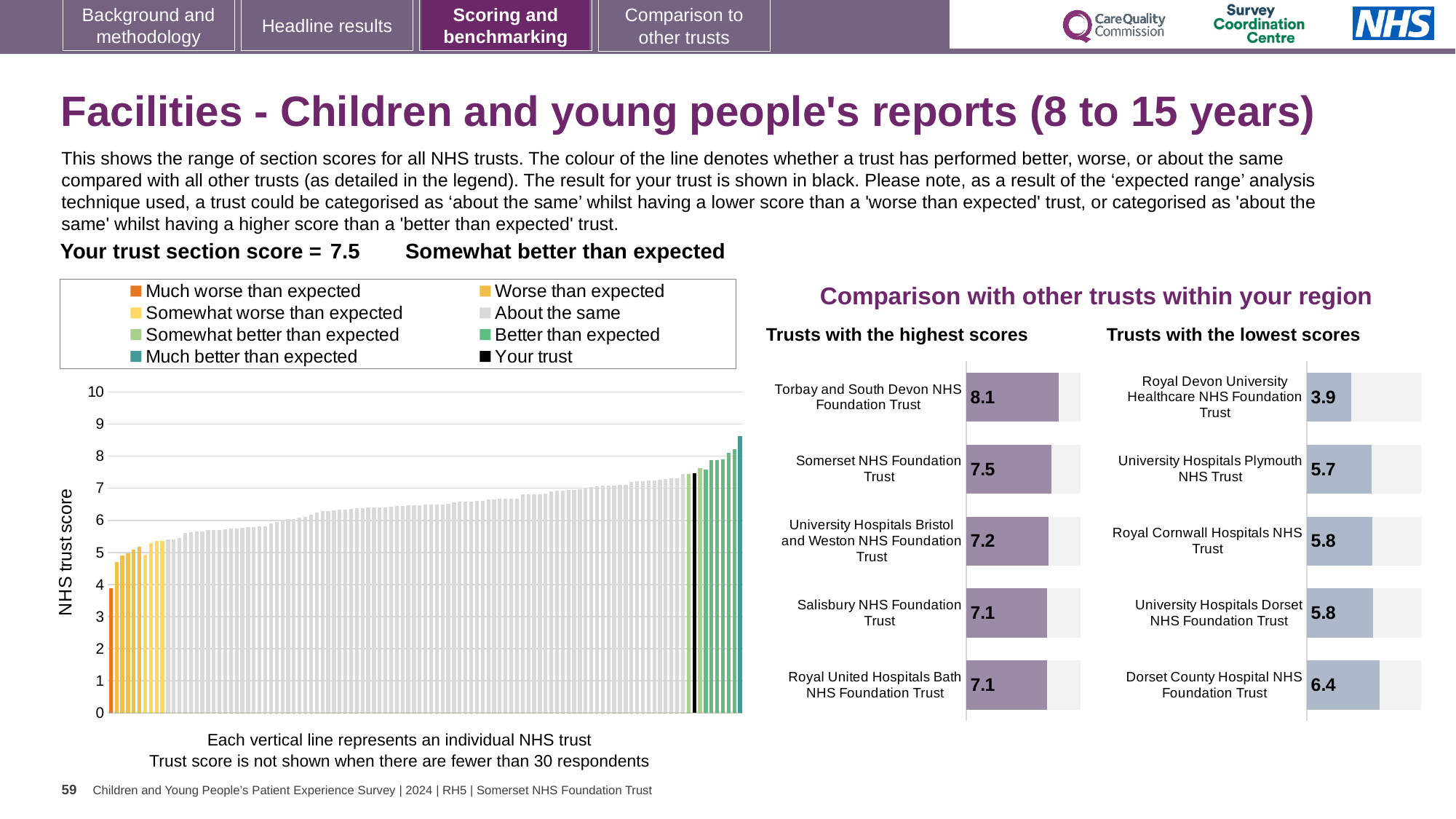
In the 'Trusts with the lowest scores' chart, which trust has the lowest score? Royal Devon University Healthcare NHS Foundation Trust In the 'Trusts with the lowest scores' chart, which has the larger score: University Hospitals Plymouth NHS Trust or Dorset County Hospital NHS Foundation Trust? Dorset County Hospital NHS Foundation Trust In the 'Trusts with the highest scores' chart, what is the score for Torbay and South Devon NHS Foundation Trust? 8.1 In the 'Trusts with the highest scores' chart, what is the difference between the scores of Torbay and South Devon NHS Foundation Trust and Somerset NHS Foundation Trust? 0.6 In the 'Trusts with the lowest scores' chart, what is the score for Royal Devon University Healthcare NHS Foundation Trust? 3.9 In the 'Trusts with the lowest scores' chart, what is the score for Dorset County Hospital NHS Foundation Trust? 6.4 What kind of chart is the 'NHS trust score' chart on the left of the slide? Bar chart How many entries does the legend of the 'NHS trust score' chart on the left list? 8 In the 'NHS trust score' chart on the left, do the bar values rise or fall from left to right? Rise In the 'Trusts with the lowest scores' chart, what is the difference between the scores of Dorset County Hospital NHS Foundation Trust and Royal Devon University Healthcare NHS Foundation Trust? 2.5 How many trusts are listed in the 'Trusts with the highest scores' chart? 5 In the 'Trusts with the highest scores' chart, which trust has the highest score? Torbay and South Devon NHS Foundation Trust